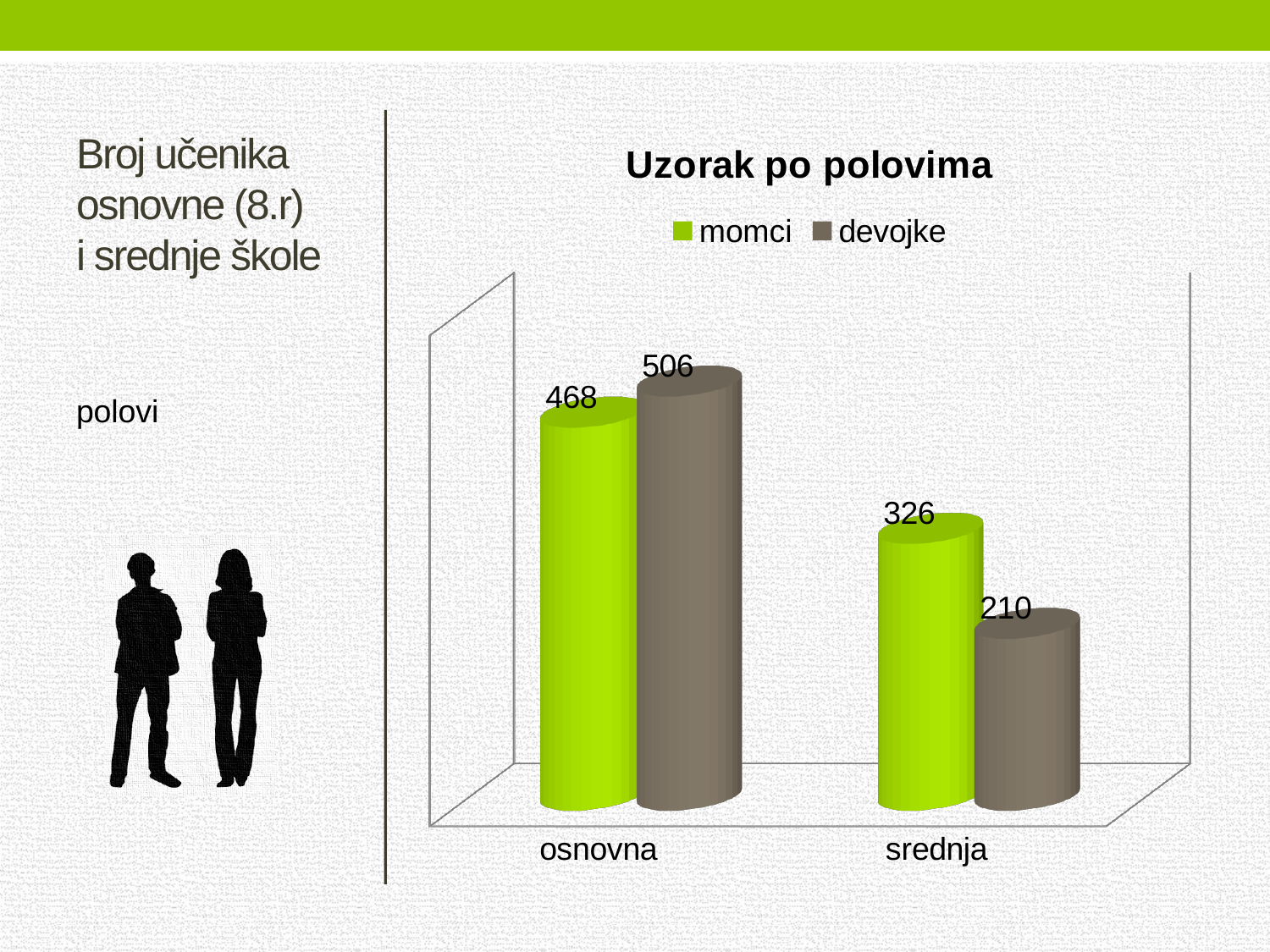
What is the difference between devojke and momci in the osnovna category? 38 How many categories are shown on the x axis? 2 Which is larger in the srednja category, momci or devojke? momci Which category has the lowest value for momci? srednja What is the value for momci in the osnovna category? 468 What is the difference between momci and devojke in the srednja category? 116 What is the value for devojke in the srednja category? 210 What is the value for devojke in the osnovna category? 506 Which category has the highest value for devojke? osnovna How many series does the legend list? 2 What is the value for momci in the srednja category? 326 What is the title of the chart? Uzorak po polovima